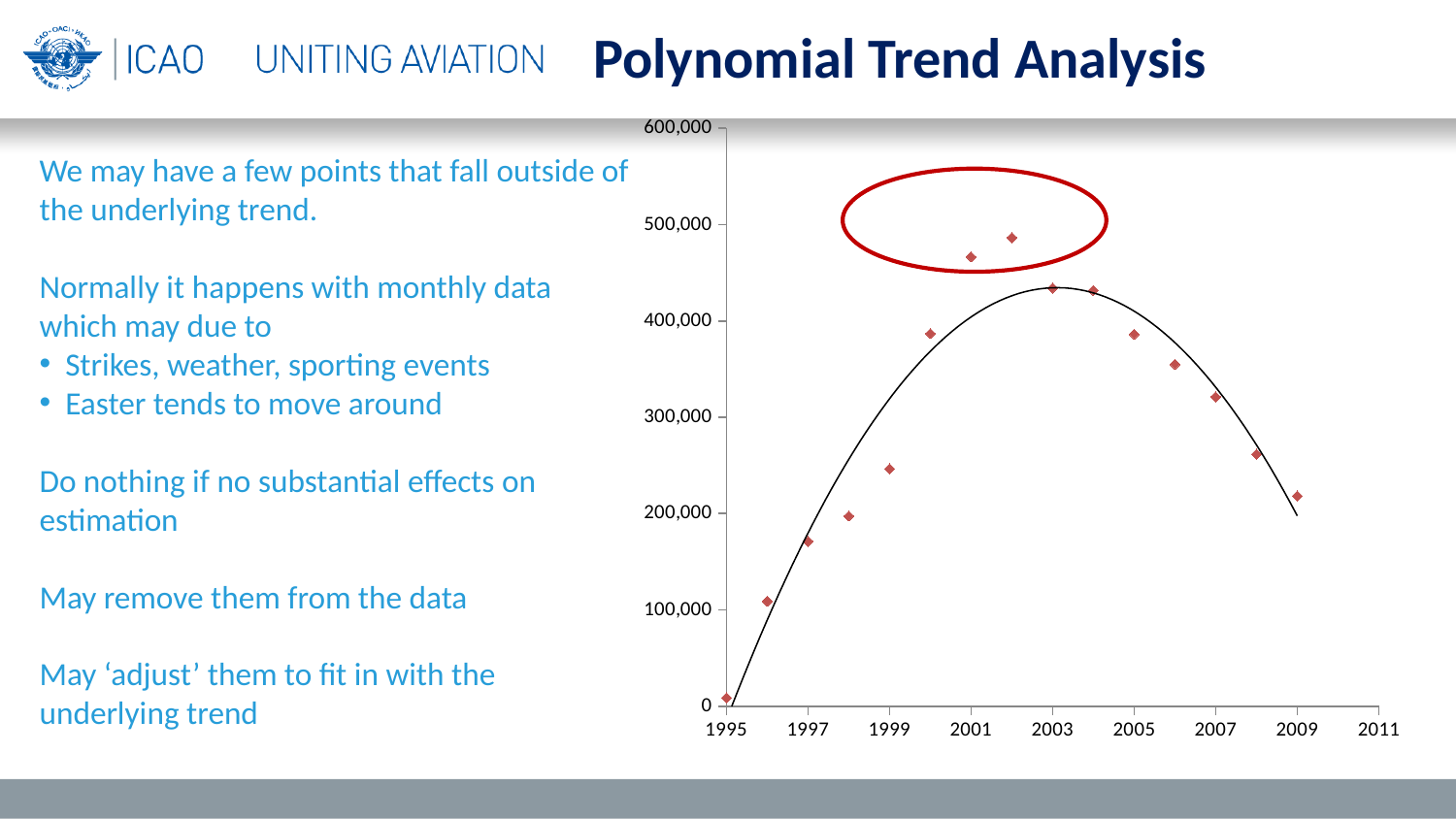
Is the value for 1999 greater or less than 300,000? less Which is larger, the value for 1997 or the value for 2008? 2008 Which is larger, the value for 2001 or the value for 2005? 2001 Do the plotted values rise or fall from 2003 to 2009? fall Is the value for 2009 greater or less than 200,000? greater What kind of chart is shown on the slide? scatter chart Which year has the highest plotted value? 2002 How many data points are plotted on the chart? 15 Which year has the lowest plotted value? 1995 Is the value for 2002 greater or less than 400,000? greater What colour is the ellipse drawn around the points that fall outside the trend? red